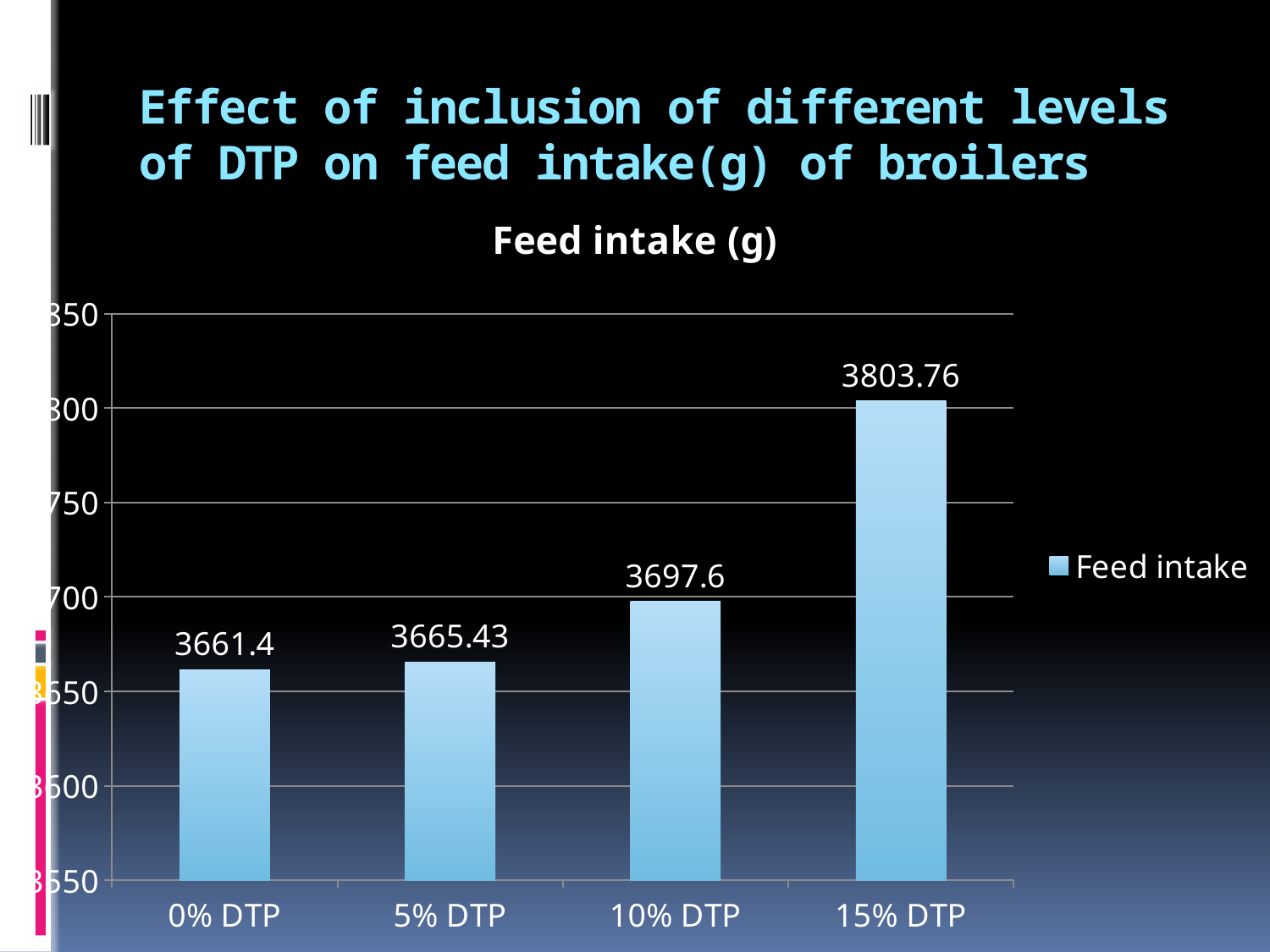
How many DTP levels are shown on the x axis? 4 What kind of chart is shown on the slide? Bar chart What is the feed intake value for 15% DTP? 3803.76 What is the feed intake value for 5% DTP? 3665.43 What is the feed intake value for 10% DTP? 3697.6 Which DTP level has the lowest feed intake? 0% DTP Does feed intake rise or fall as the DTP level increases from 0% to 15%? Rises What is the difference in feed intake between 15% DTP and 0% DTP? 142.36 What is the difference in feed intake between 10% DTP and 5% DTP? 32.17 What is the feed intake value for 0% DTP? 3661.4 Which DTP level has the highest feed intake? 15% DTP Which has a larger feed intake, 10% DTP or 15% DTP? 15% DTP